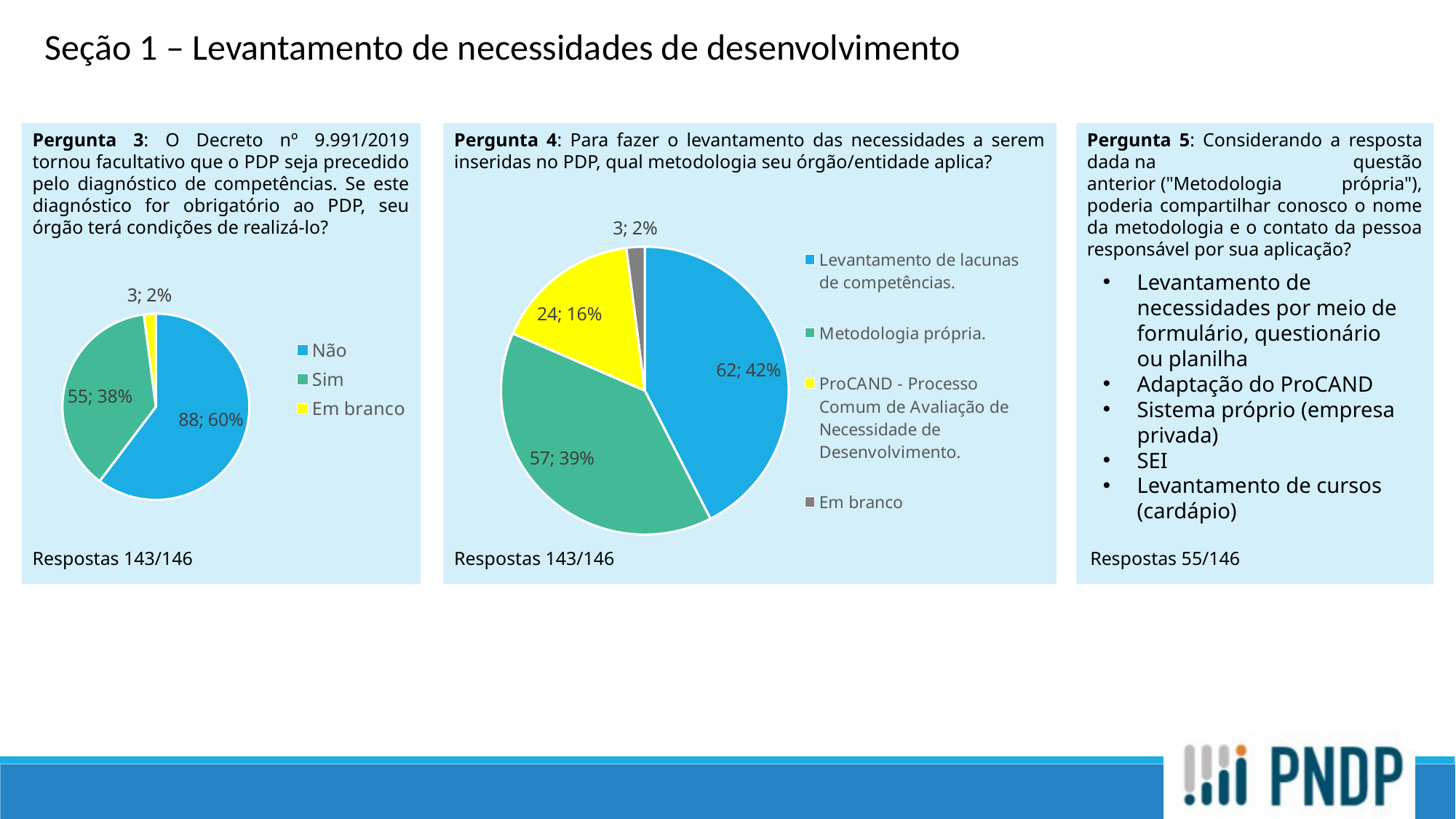
In the Pergunta 4 pie chart, which is larger: the count for "Levantamento de lacunas de competências." or for "Metodologia própria."? Levantamento de lacunas de competências. In the Pergunta 3 pie chart, what is the difference between the counts for "Não" and "Sim"? 33 In the Pergunta 4 pie chart, what share of the pie does "ProCAND - Processo Comum de Avaliação de Necessidade de Desenvolvimento." represent? 16% What type of chart is used for Pergunta 4? Pie chart In the Pergunta 4 pie chart, what is the data label for "Metodologia própria."? 57; 39% How many categories does the legend of the Pergunta 3 pie chart list? 3 In the Pergunta 3 pie chart, what share of the pie does "Sim" represent? 38% In the Pergunta 3 pie chart, what is the data label for "Não"? 88; 60% In the Pergunta 4 pie chart, what colour is the "Em branco" slice? Grey In the Pergunta 4 pie chart, which category has the largest slice? Levantamento de lacunas de competências. In the Pergunta 3 pie chart, which category has the smallest slice? Em branco How many categories does the legend of the Pergunta 4 pie chart list? 4